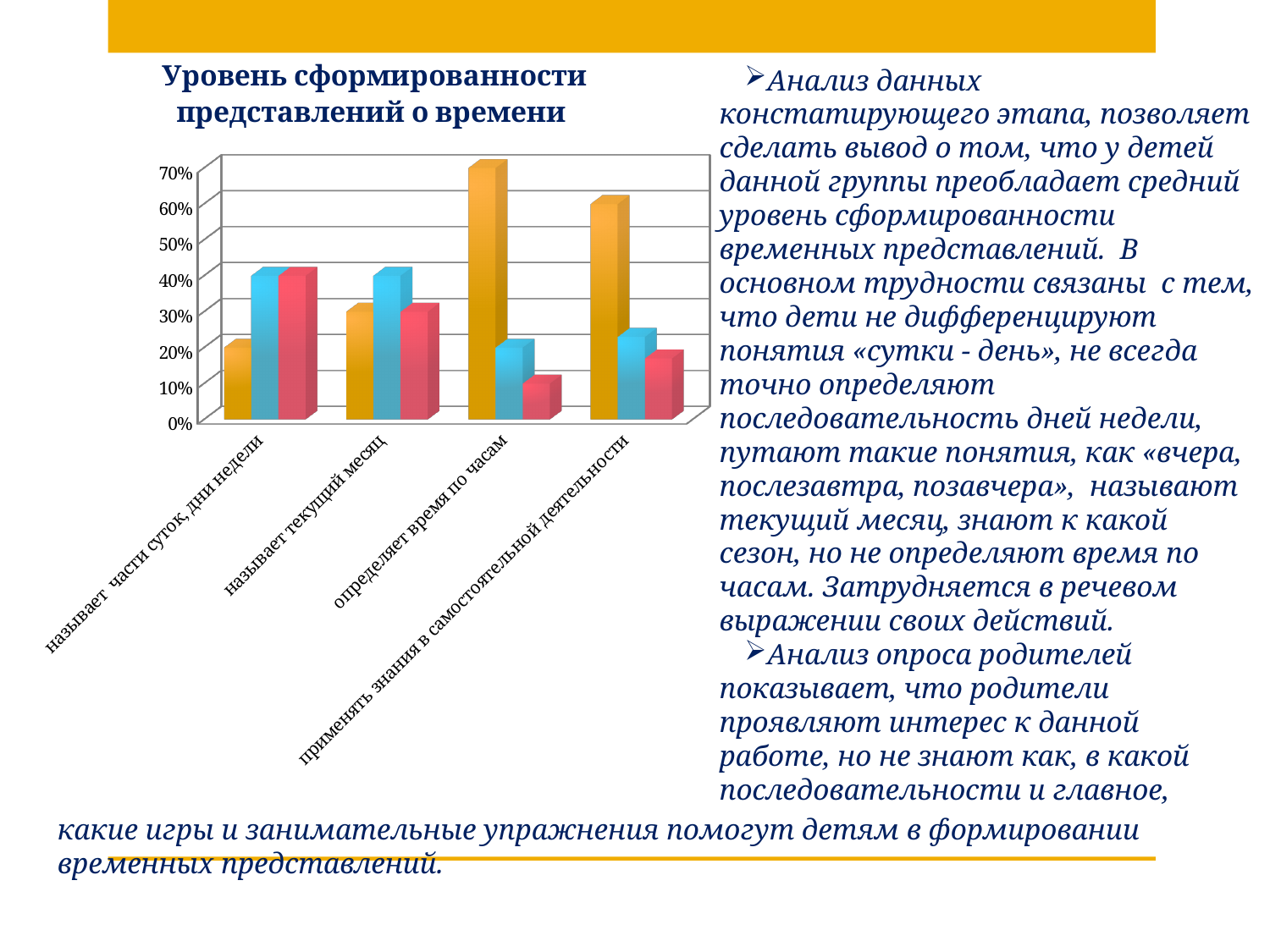
Is the orange bar for "называет части суток, дни недели" greater or less than 30%? less Which category has the shortest orange bar? называет части суток, дни недели What is the title of the chart? Уровень сформированности представлений о времени What kind of chart is shown on the slide? bar chart Is the red bar for "определяет время по часам" greater or less than 20%? less Which category has the tallest orange bar? определяет время по часам For "определяет время по часам", which is larger: the orange bar or the red bar? the orange bar Is the blue bar for "называет текущий месяц" greater or less than 30%? greater How many categories are shown on the x axis of the chart? 4 For "называет части суток, дни недели", which is larger: the orange bar or the blue bar? the blue bar